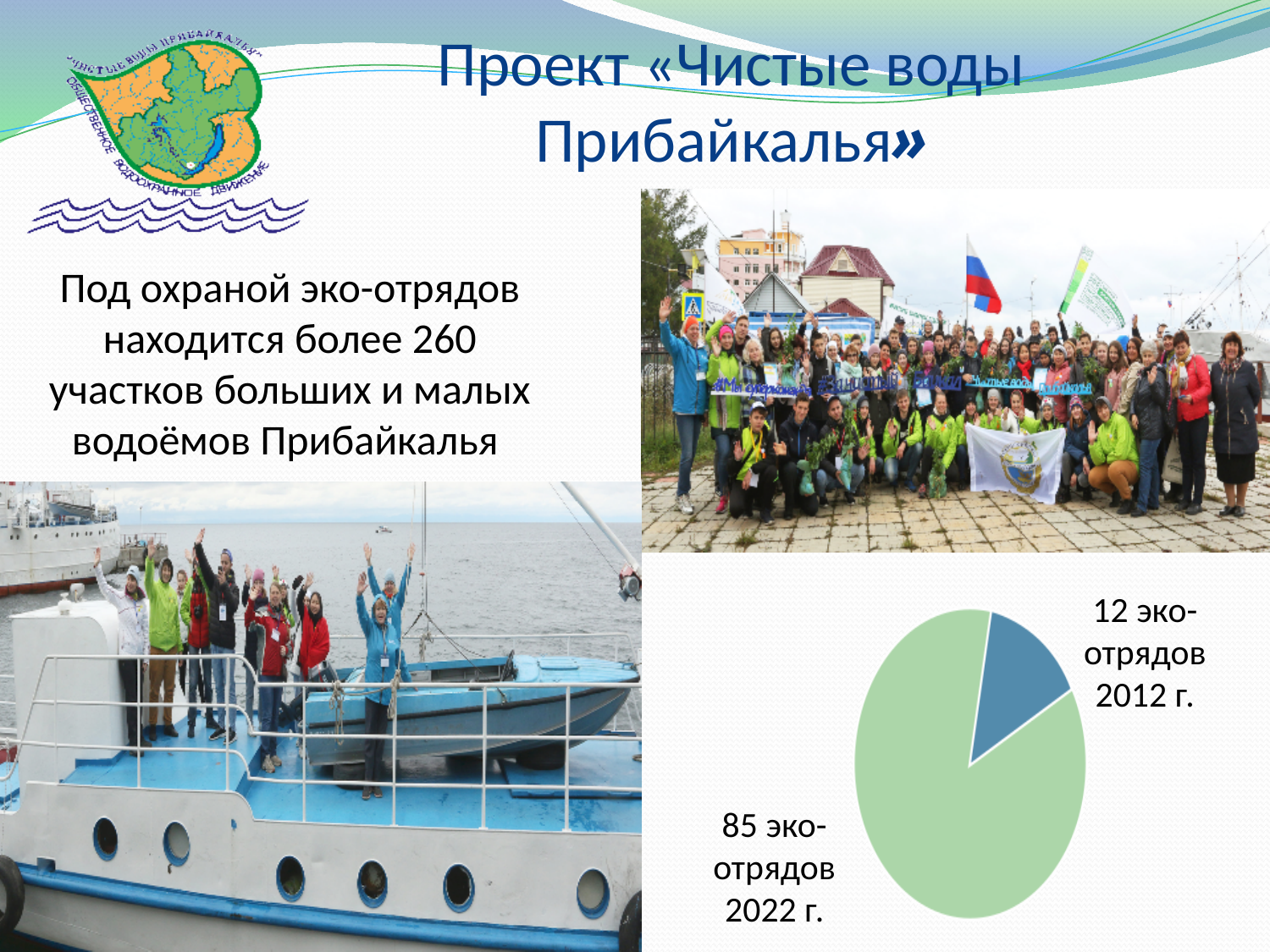
How many eco-squads does the pie chart show for 2012? 12 What colour is the slice for 12 eco-squads in 2012? blue Which year has the larger slice in the pie chart, 2012 or 2022? 2022 How many slices does the pie chart have? 2 Which year has the smaller slice in the pie chart? 2012 Is the number of eco-squads in 2022 larger or smaller than in 2012? larger By how many eco-squads did the number grow from 2012 to 2022 according to the pie chart? 73 What colour is the slice for 85 eco-squads in 2022? green What type of chart is shown on the slide? pie chart How many eco-squads does the pie chart show for 2022? 85 What is the combined number of eco-squads shown in the two slices of the pie chart? 97